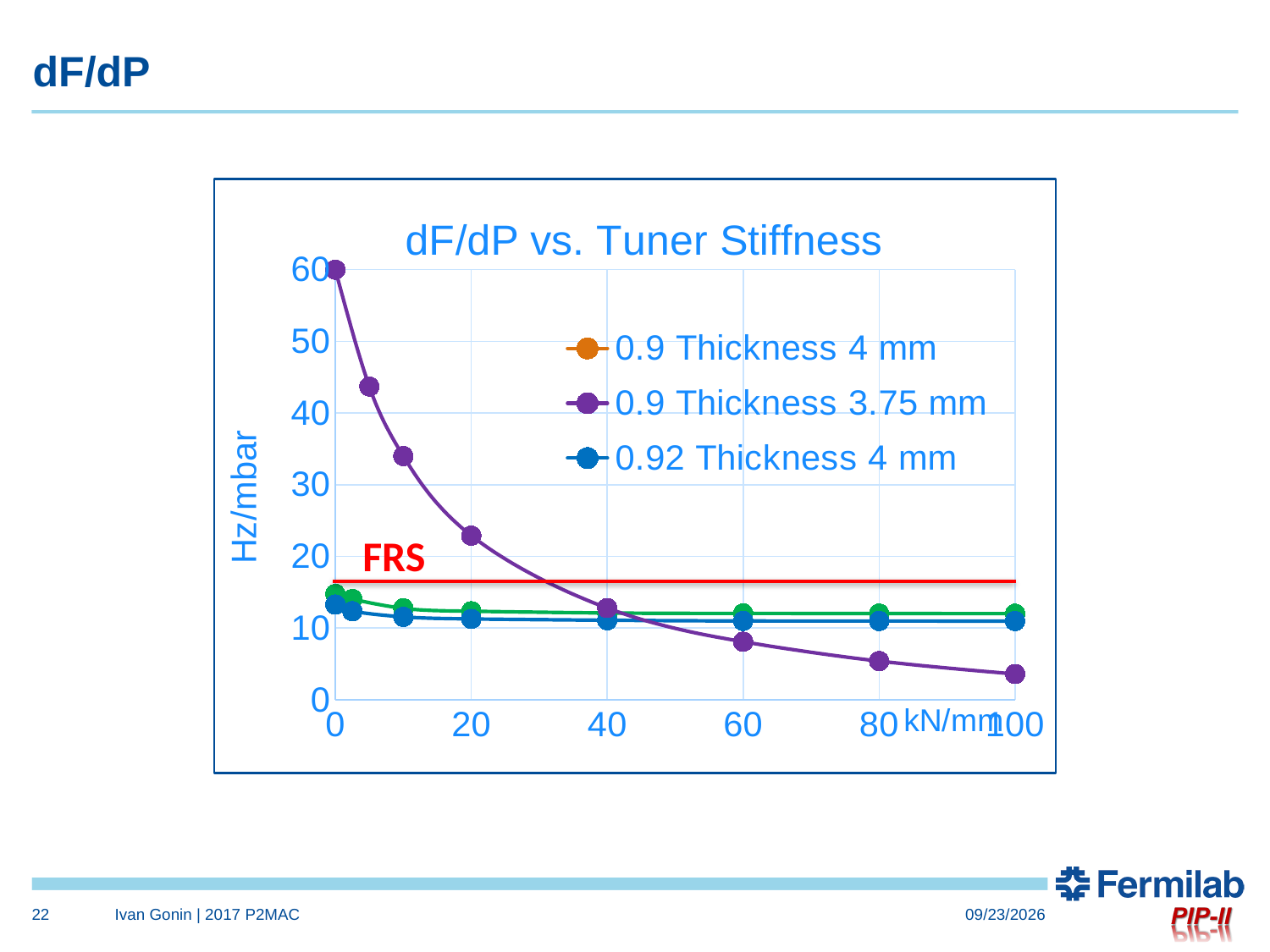
At 0 kN/mm, which series has the larger value: 0.9 Thickness 3.75 mm or 0.92 Thickness 4 mm? 0.9 Thickness 3.75 mm At 100 kN/mm, which series has the larger value: 0.9 Thickness 3.75 mm or 0.92 Thickness 4 mm? 0.92 Thickness 4 mm What kind of chart is shown on the slide? line chart Is the value for the 0.9 Thickness 3.75 mm series at 10 kN/mm greater or less than 30? greater What is the title of the chart? dF/dP vs. Tuner Stiffness What is the label on the y axis of the chart? Hz/mbar Does the value for the 0.9 Thickness 3.75 mm series rise or fall as tuner stiffness increases along the x axis? fall Is the value for the 0.9 Thickness 3.75 mm series at 60 kN/mm greater or less than 10? less Is the value for the 0.9 Thickness 3.75 mm series at 20 kN/mm greater or less than 20? greater How many series does the chart legend list? 3 What is the value of the 0.9 Thickness 3.75 mm series at 0 kN/mm? 60